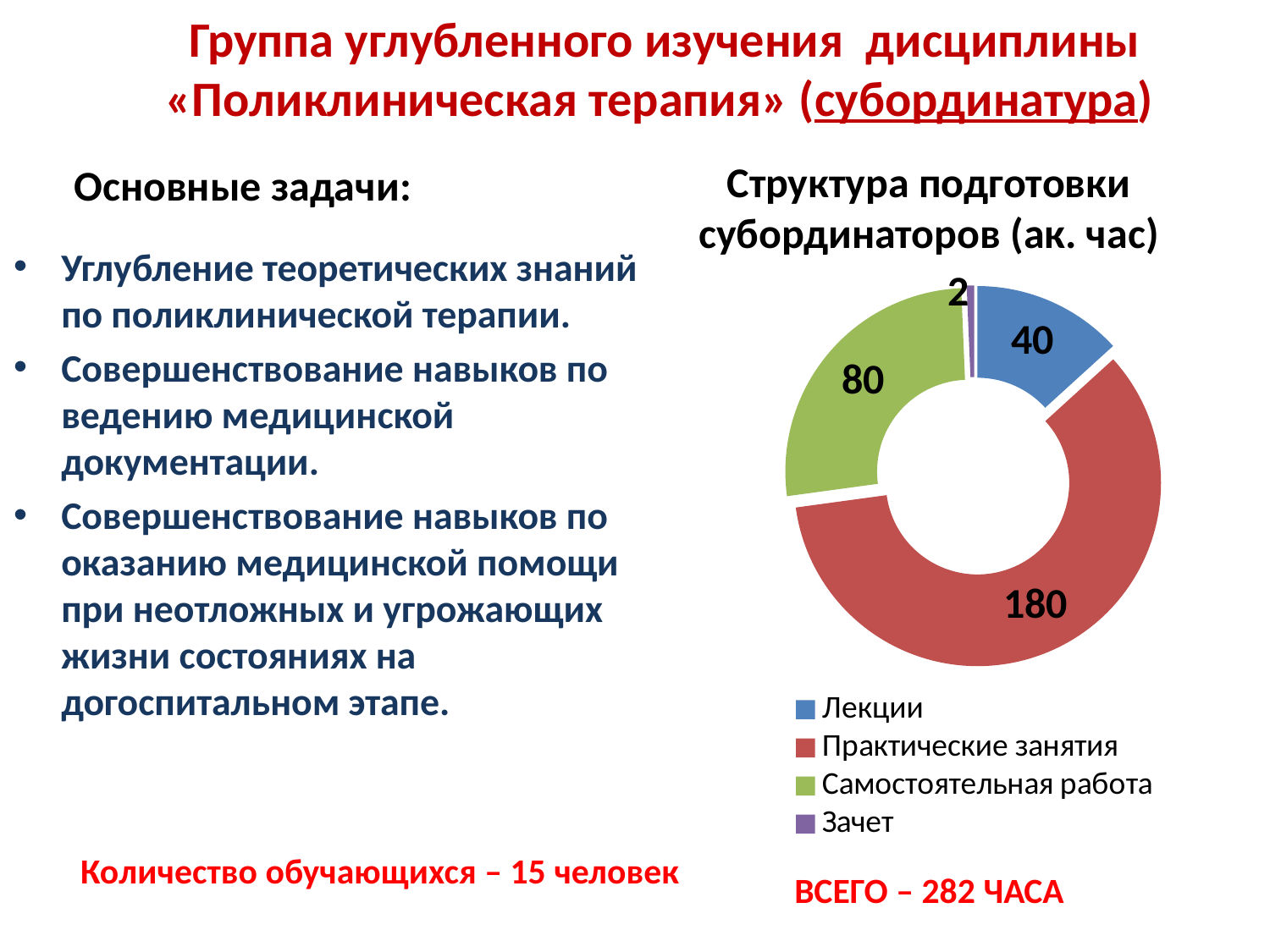
What is the value for Самостоятельная работа in the chart? 80 What is the difference between the values for Практические занятия and Самостоятельная работа? 100 What is the value for Практические занятия in the chart? 180 What is the title of the chart? Структура подготовки субординаторов (ак. час) Which category has the lowest value in the chart? Зачет Which category has the highest value in the chart? Практические занятия What kind of chart is shown on the slide? doughnut chart What is the difference between the values for Самостоятельная работа and Лекции? 40 What is the value for Лекции in the chart? 40 How many categories are shown in the chart? 4 What is the value for Зачет in the chart? 2 Which is larger: the value for Лекции or the value for Самостоятельная работа? Самостоятельная работа